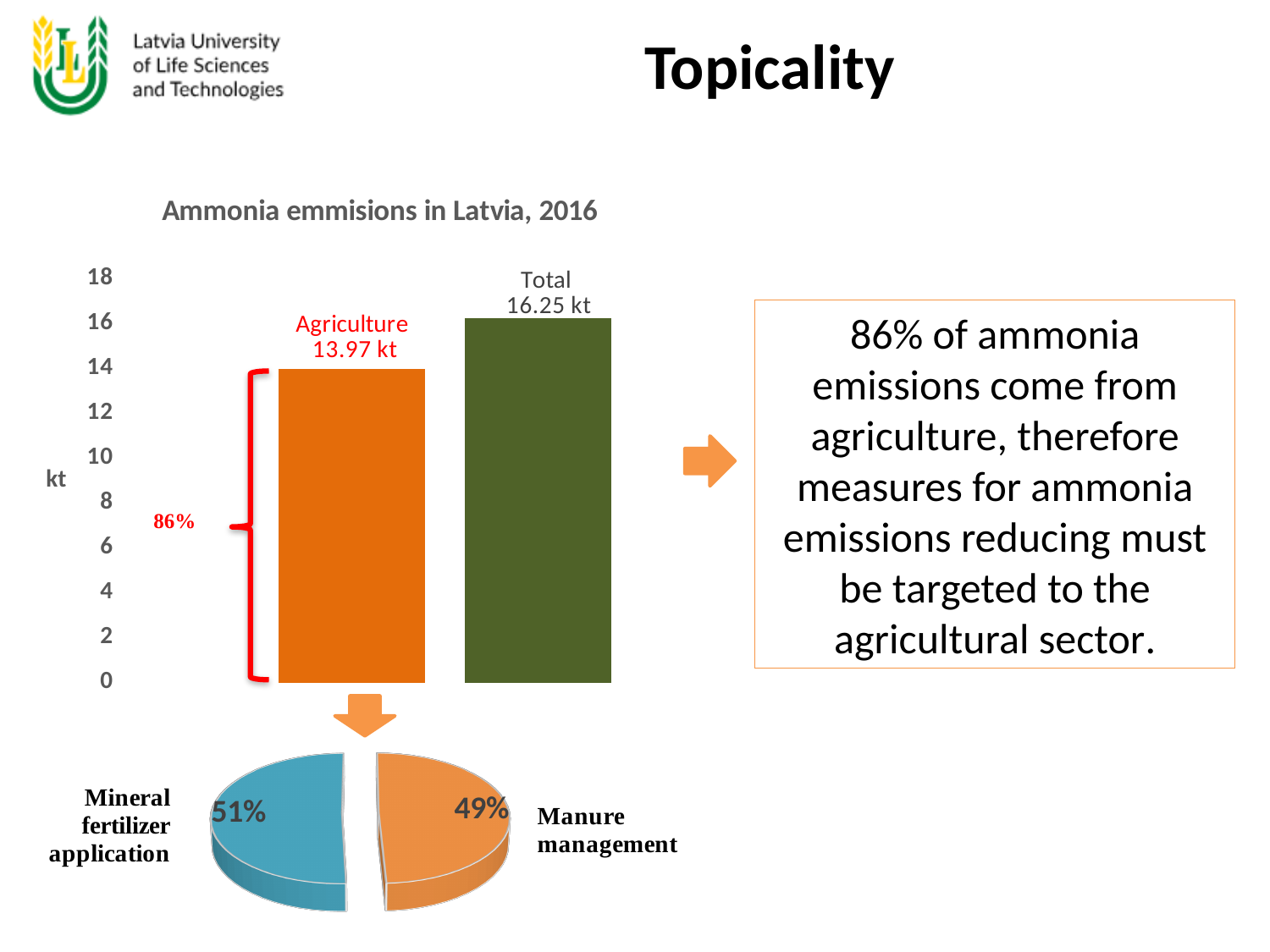
In the pie chart at the bottom of the slide, how many slices are there? 2 What kind of chart is the chart titled 'Ammonia emmisions in Latvia, 2016'? bar chart In the bar chart titled 'Ammonia emmisions in Latvia, 2016', how many bars are plotted? 2 In the bar chart titled 'Ammonia emmisions in Latvia, 2016', is the value for Agriculture greater or less than 12? greater In the bar chart titled 'Ammonia emmisions in Latvia, 2016', what is the value for Total? 16.25 kt In the bar chart titled 'Ammonia emmisions in Latvia, 2016', what percentage of the total is marked next to the Agriculture bar? 86% In the bar chart titled 'Ammonia emmisions in Latvia, 2016', what unit is shown on the vertical axis? kt In the pie chart at the bottom of the slide, what share is Mineral fertilizer application? 51% In the pie chart at the bottom of the slide, what share is Manure management? 49% In the bar chart titled 'Ammonia emmisions in Latvia, 2016', which bar is higher, Agriculture or Total? Total In the bar chart titled 'Ammonia emmisions in Latvia, 2016', what is the value for Agriculture? 13.97 kt In the bar chart titled 'Ammonia emmisions in Latvia, 2016', what is the difference between the Total and Agriculture values? 2.28 kt